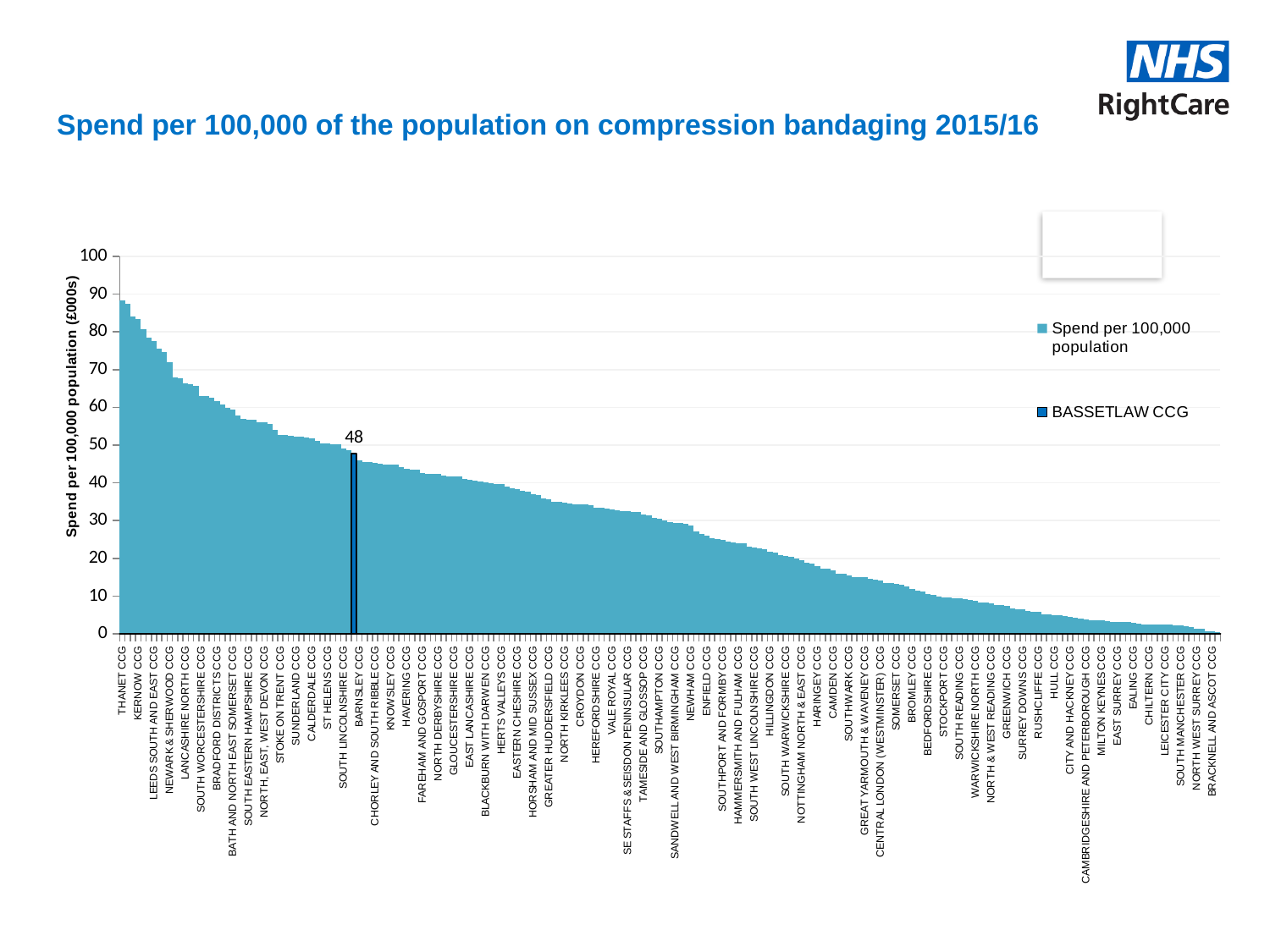
Do the values rise or fall moving from left to right along the x axis? fall What is the title of the chart? Spend per 100,000 of the population on compression bandaging 2015/16 What is the value shown for BASSETLAW CCG? 48 What is the label of the y axis? Spend per 100,000 population (£000s) Is the value for HULL CCG greater or less than 10? less What kind of chart is shown on the slide? bar chart Is the value for THANET CCG greater or less than 80? greater Which has the larger value, BASSETLAW CCG or CROYDON CCG? BASSETLAW CCG Is the value for LANCASHIRE NORTH CCG greater or less than 60? greater How many series does the legend list? 2 Which CCG has the highest spend per 100,000 population? THANET CCG